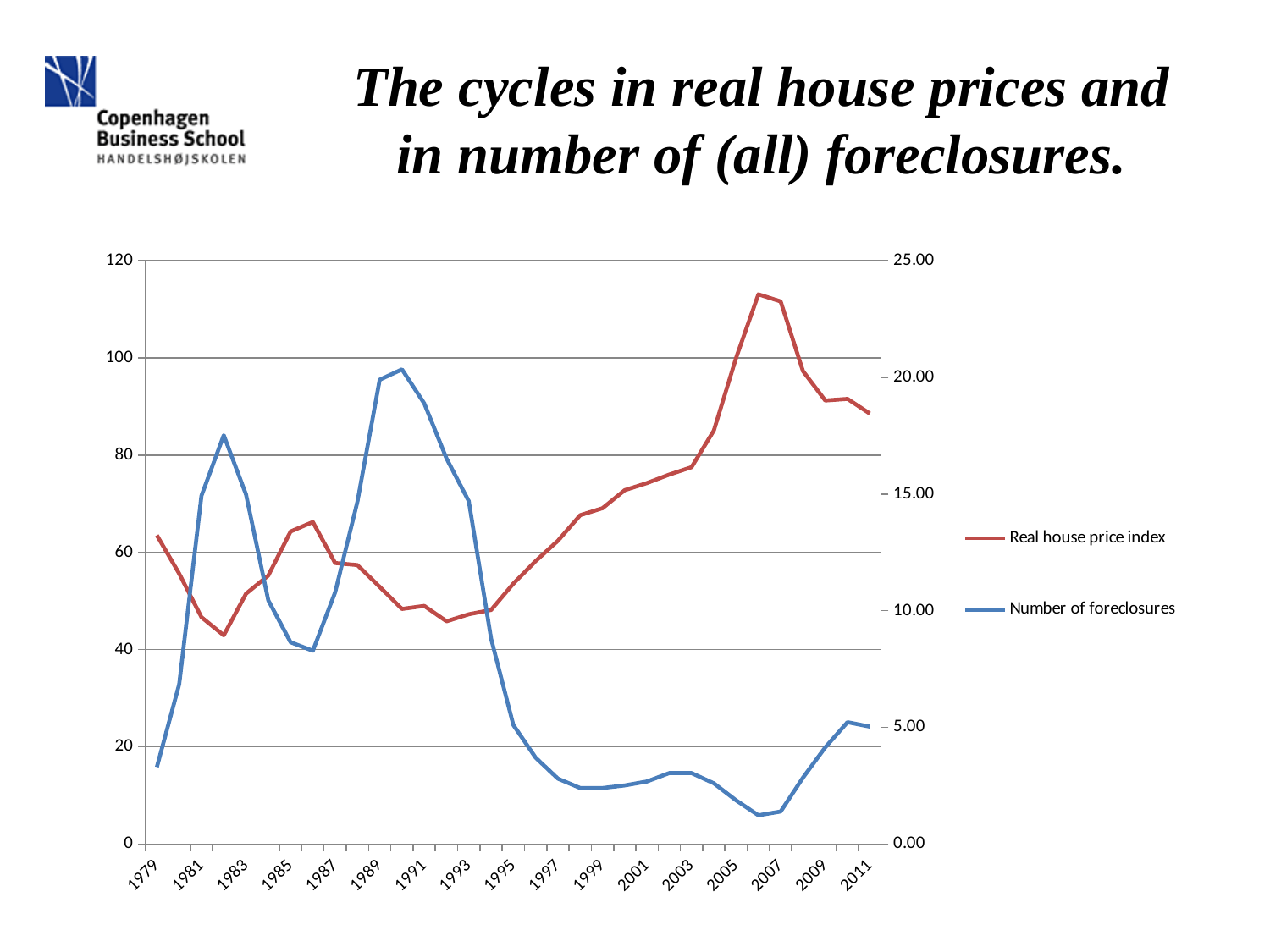
In which year does the Real house price index reach its highest value? 2006 What kind of chart is shown on the slide? line chart What is the highest value shown on the right-hand vertical axis? 25.00 Is the Number of foreclosures in 1999 greater or less than 5.00 on the right axis? less Which series is drawn in red? Real house price index Is the Real house price index in 2006 greater or less than 100 on the left axis? greater In which year is the Real house price index at its lowest? 1982 How many series does the legend list? 2 Which is larger: the Number of foreclosures in 1990 or in 2010? 1990 In which year does the Number of foreclosures reach its highest value? 1990 Does the Real house price index rise or fall between 1995 and 2006? rise Is the Number of foreclosures in 1990 greater or less than 15.00 on the right axis? greater